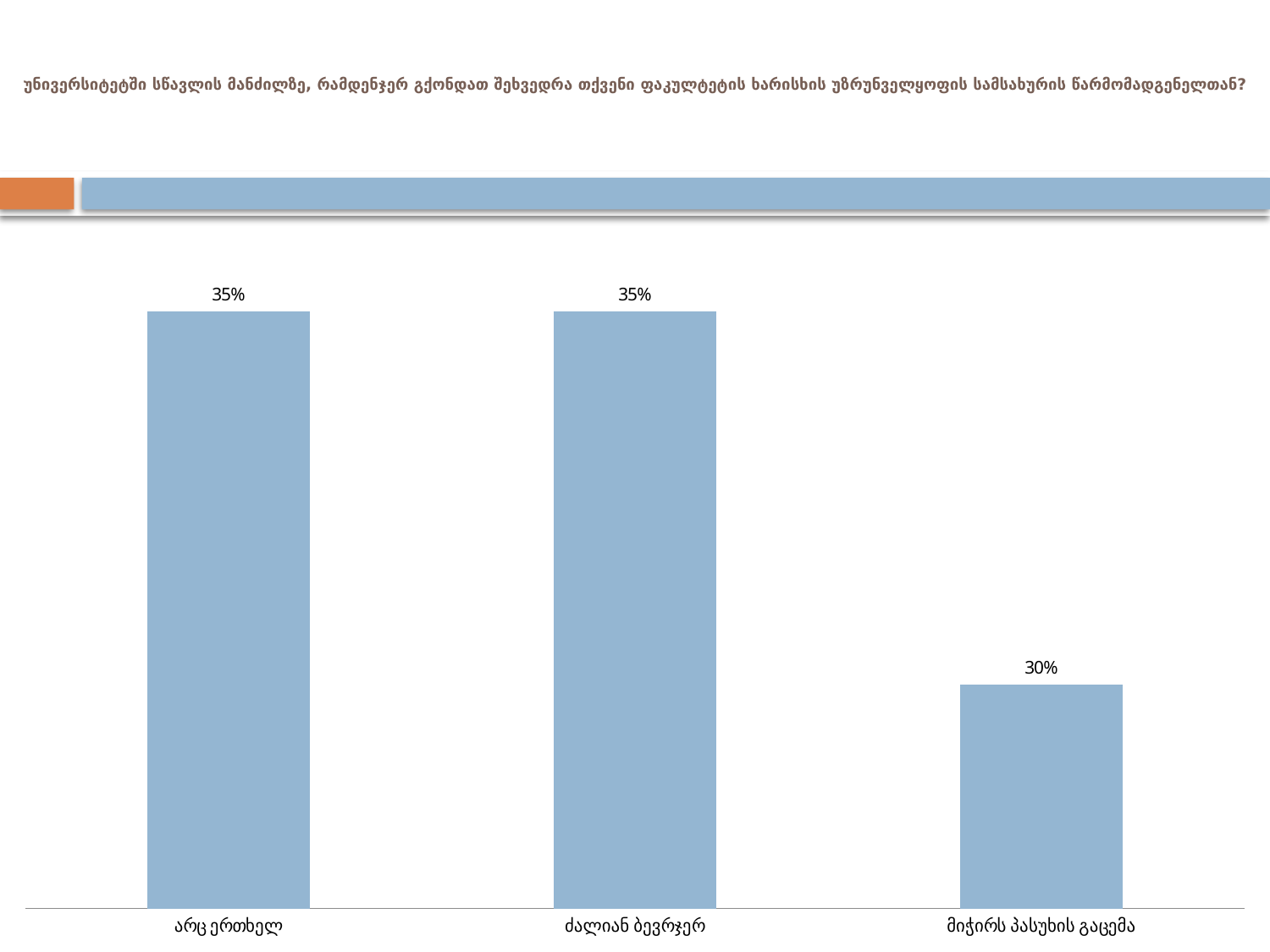
What colour are the bars in the chart? Light blue What is the sum of the values of all three bars? 100% What is the value for "მიჭირს პასუხის გაცემა"? 30% What kind of chart is shown on the slide? Bar chart What is the difference between the value for "არც ერთხელ" and the value for "ძალიან ბევრჯერ"? 0% Which category has the lowest value? მიჭირს პასუხის გაცემა What is the value for "არც ერთხელ"? 35% What is the value for "ძალიან ბევრჯერ"? 35% Which is larger, the value for "ძალიან ბევრჯერ" or the value for "მიჭირს პასუხის გაცემა"? ძალიან ბევრჯერ How many categories are shown in the chart? 3 Which is larger, the value for "არც ერთხელ" or the value for "მიჭირს პასუხის გაცემა"? არც ერთხელ What is the difference between the value for "ძალიან ბევრჯერ" and the value for "მიჭირს პასუხის გაცემა"? 5%